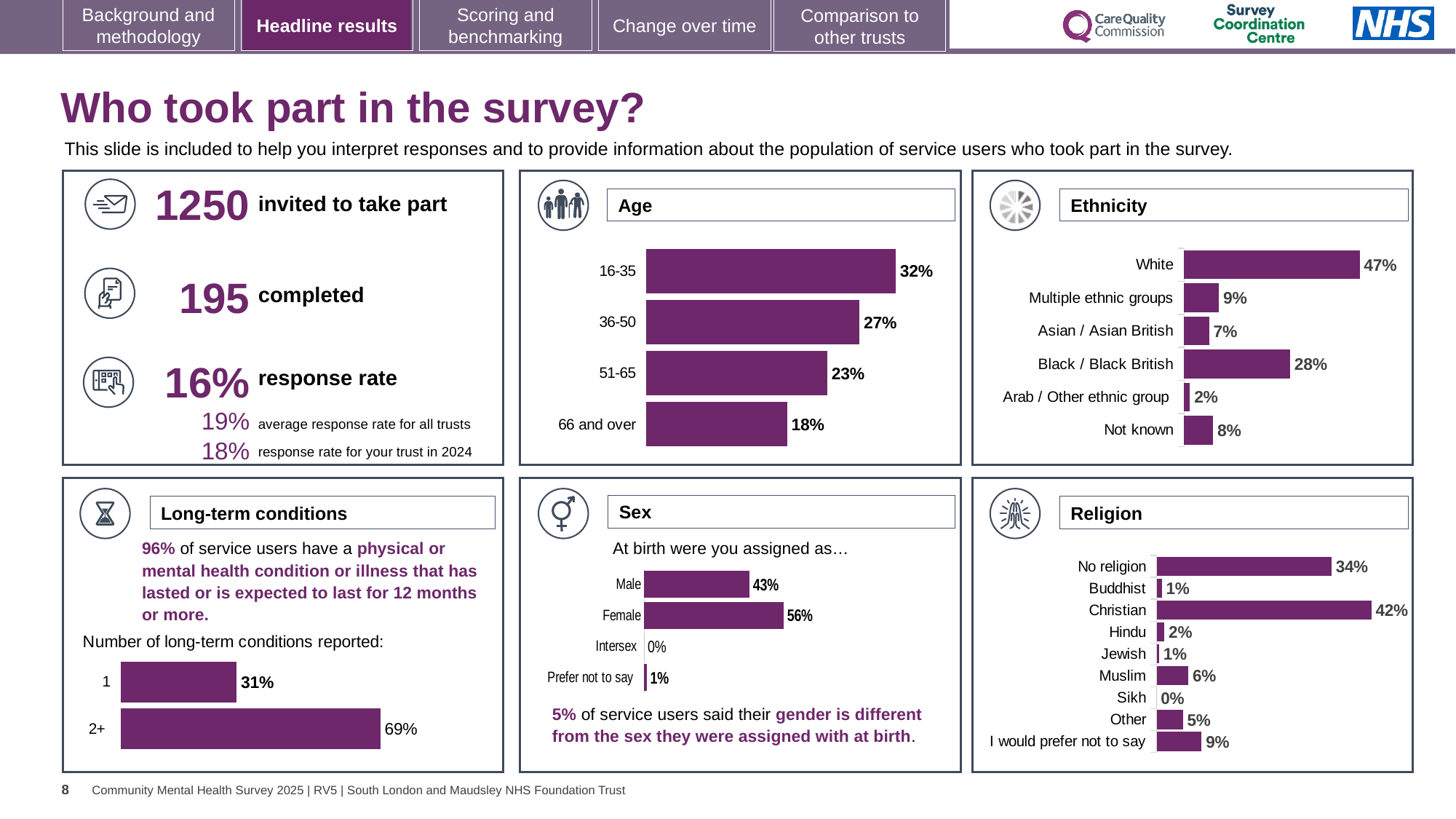
In the Ethnicity chart, which category has the highest percentage? White What type of chart is used in the Age panel? Bar chart In the Religion chart, what is the value for Christian? 42% In the Long-term conditions chart, what percentage reported 2+ conditions? 69% In the Ethnicity chart, what is the difference between White and Multiple ethnic groups? 38% In the Age chart, what percentage of respondents were aged 16-35? 32% In the Age chart, which age group has the lowest percentage? 66 and over In the Ethnicity chart, what is the value for Black / Black British? 28% In the Sex chart, what percentage of respondents were assigned Female at birth? 56% In the Sex chart, which is larger, Male or Female? Female In the Ethnicity chart, how many categories are shown? 6 In the Religion chart, how many categories are listed? 9